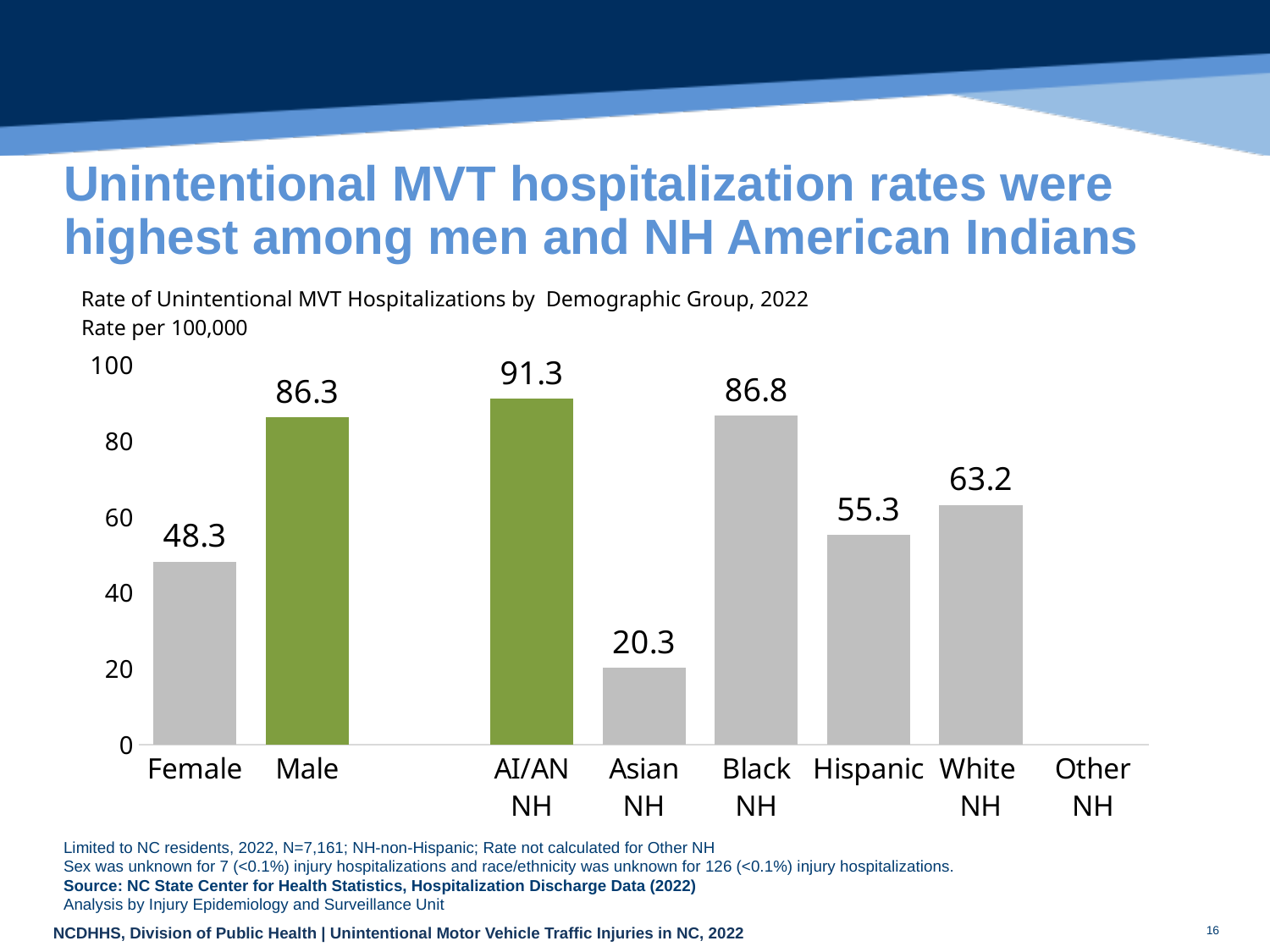
What is the difference between the White NH and Hispanic rates of unintentional MVT hospitalizations? 7.9 What is the difference between the Male and Female rates of unintentional MVT hospitalizations? 38.0 Which two bars are coloured green in the chart? Male and AI/AN NH What is the rate of unintentional MVT hospitalizations for Hispanic? 55.3 What kind of chart is shown on the slide? bar chart What is the rate of unintentional MVT hospitalizations for Female? 48.3 How many demographic groups have a bar plotted in the chart? 7 Which demographic group has the highest rate of unintentional MVT hospitalizations? AI/AN NH Is the rate for Black NH greater or less than 80? greater Which demographic group with a plotted bar has the lowest rate of unintentional MVT hospitalizations? Asian NH What is the rate of unintentional MVT hospitalizations for Asian NH? 20.3 Which has a higher rate of unintentional MVT hospitalizations, Hispanic or White NH? White NH